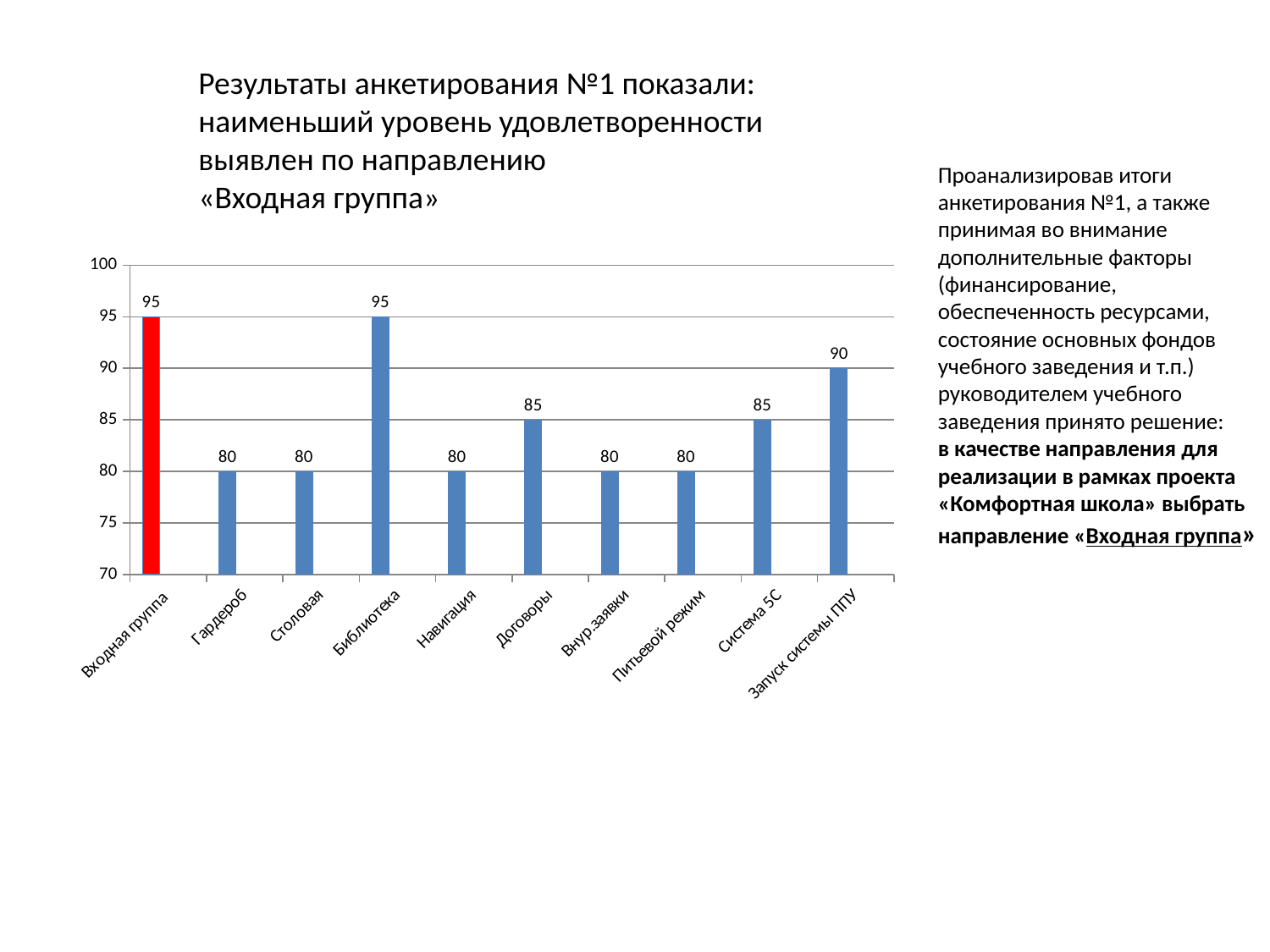
What is the difference between the values for Запуск системы ППУ and Система 5С? 5 What is the difference between the values for Библиотека and Навигация? 15 How many categories are shown on the x axis of the chart? 10 What is the value for Библиотека? 95 What is the value for Договоры? 85 What kind of chart is shown on the slide? bar chart What is the value for Гардероб? 80 What is the value for Запуск системы ППУ? 90 Which is larger, the value for Питьевой режим or the value for Запуск системы ППУ? Запуск системы ППУ Which is larger, the value for Входная группа or the value for Столовая? Входная группа What is the value for Входная группа? 95 Which category's bar is coloured red in the chart? Входная группа